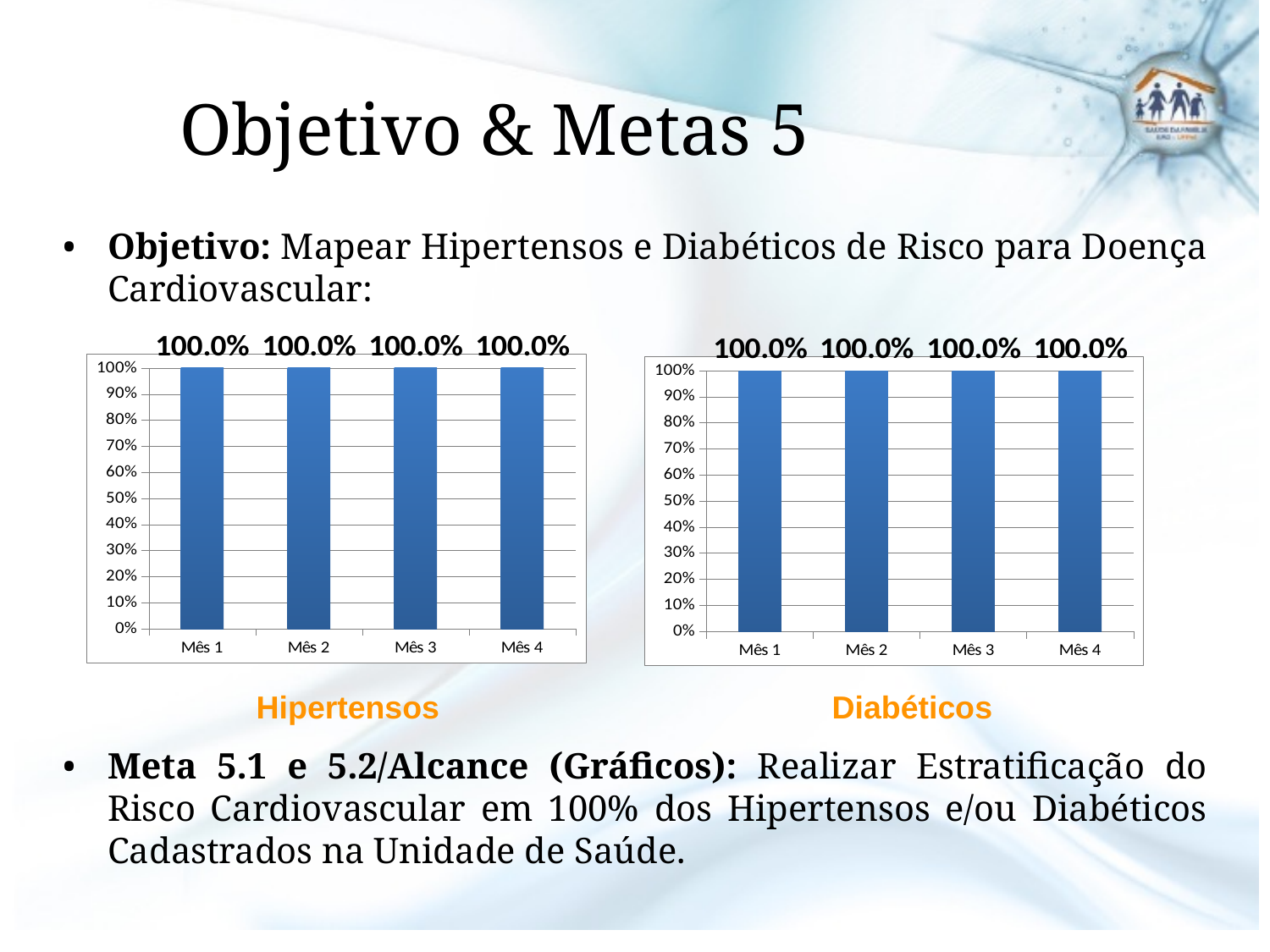
What kind of chart is the Diabéticos chart on the right? Bar chart What label is written below the chart on the right? Diabéticos In the Diabéticos chart on the right, what is the value for Mês 4? 100.0% In the Diabéticos chart on the right, what is the value for Mês 2? 100.0% In the Hipertensos chart on the left, what is the value for Mês 1? 100.0% In the Diabéticos chart on the right, is the value for Mês 3 greater or less than 90%? greater In the Hipertensos chart on the left, what is the value for Mês 3? 100.0% In the Hipertensos chart on the left, do the values rise, fall or stay the same from Mês 1 to Mês 4? Stay the same What kind of chart is the Hipertensos chart on the left? Bar chart How many bars are plotted in the Diabéticos chart on the right? 4 How many categories (months) are shown in the Hipertensos chart on the left? 4 In the Hipertensos chart on the left, what is the difference between the values for Mês 1 and Mês 4? 0.0%